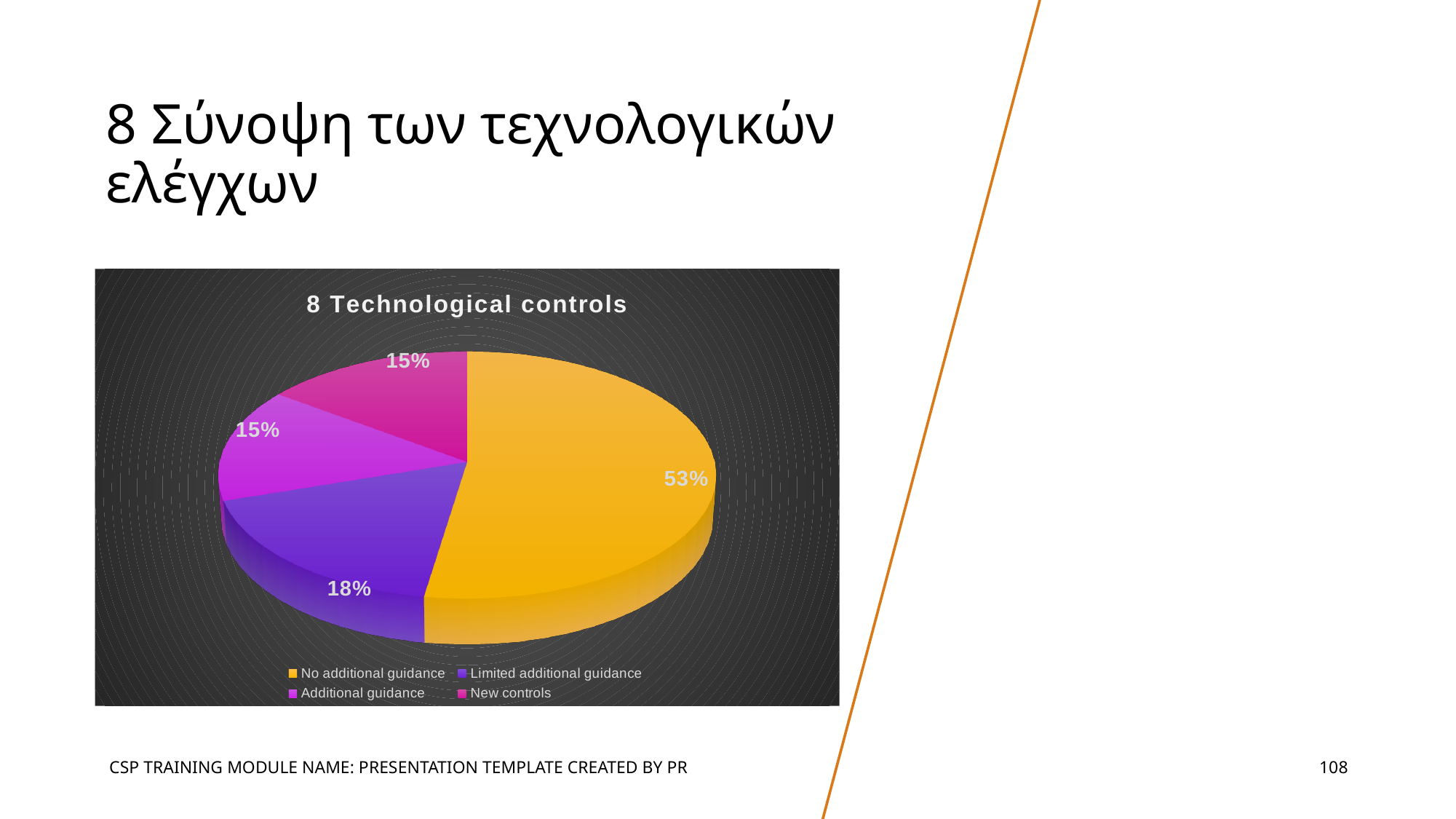
What share of the pie does "Limited additional guidance" take? 18% Which legend entry is shown in yellow? No additional guidance What kind of chart is shown on the slide? pie chart Which category has the largest slice of the pie? No additional guidance How many slices does the pie chart have? 4 How many entries does the legend list? 4 Which is larger, the slice for "Limited additional guidance" or the slice for "New controls"? Limited additional guidance What is the title of the chart? 8 Technological controls What share of the pie does "No additional guidance" take? 53% What share of the pie does "New controls" take? 15% What is the difference in percentage points between "No additional guidance" and "Limited additional guidance"? 35